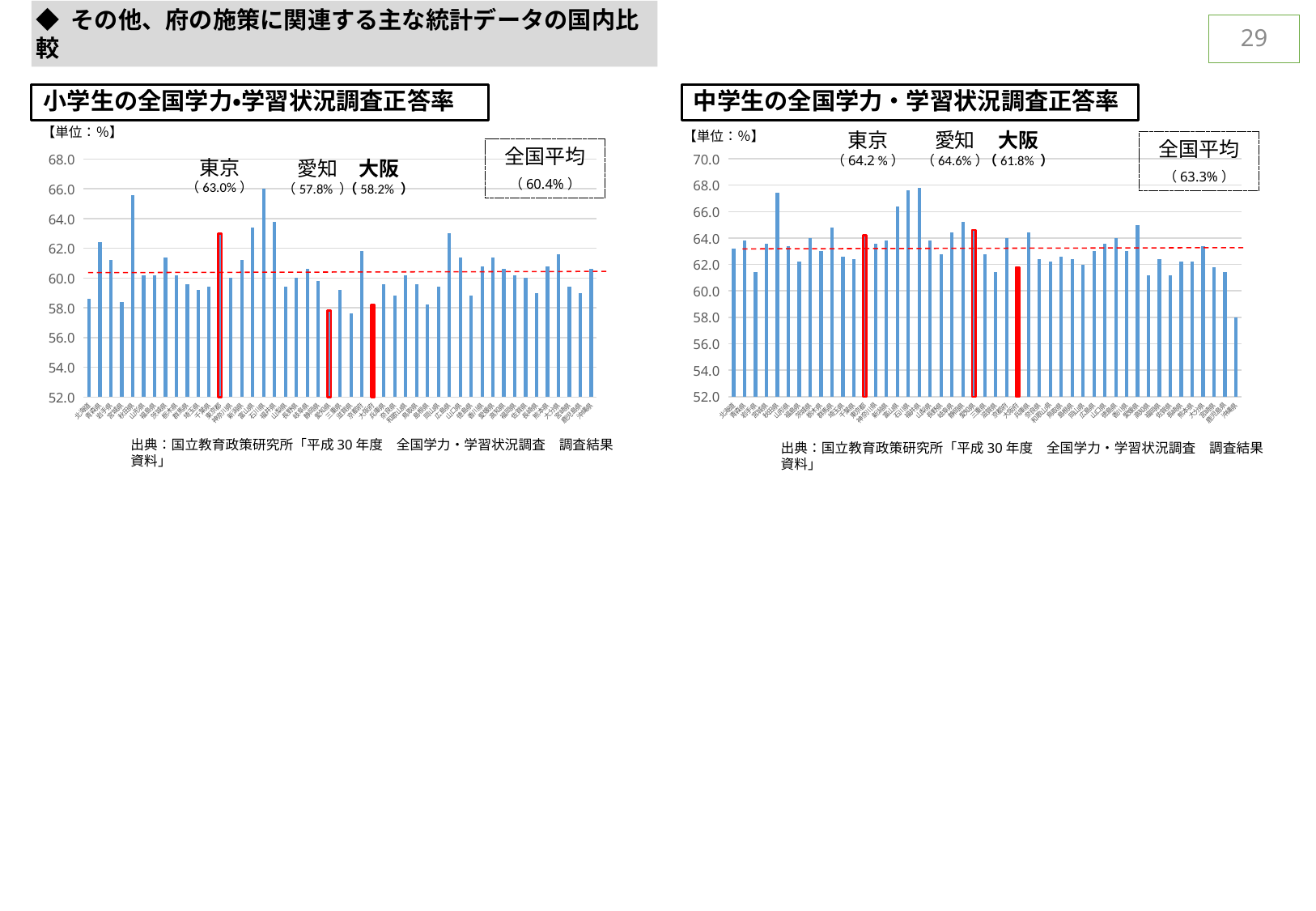
In the left chart (小学生の全国学力•学習状況調査正答率), what is the difference between the values for 東京 and 大阪? 4.8 percentage points In the right chart (中学生の全国学力・学習状況調査正答率), what is the value for 愛知? 64.6% In the right chart (中学生の全国学力・学習状況調査正答率), what is the value for 大阪? 61.8% In the right chart (中学生の全国学力・学習状況調査正答率), what is the value for 東京? 64.2% What kind of chart is used in the left chart (小学生の全国学力•学習状況調査正答率)? Bar chart In the left chart (小学生の全国学力•学習状況調査正答率), which has the larger value, 愛知 or 大阪? 大阪 In the left chart (小学生の全国学力•学習状況調査正答率), what is the 全国平均 shown? 60.4% In the left chart (小学生の全国学力•学習状況調査正答率), what is the value for 東京? 63.0% In the left chart (小学生の全国学力•学習状況調査正答率), what is the value for 大阪? 58.2% In the left chart (小学生の全国学力•学習状況調査正答率), what is the value for 愛知? 57.8% In the right chart (中学生の全国学力・学習状況調査正答率), what is the 全国平均 shown? 63.3% In the right chart (中学生の全国学力・学習状況調査正答率), what is the difference between the values for 愛知 and 大阪? 2.8 percentage points